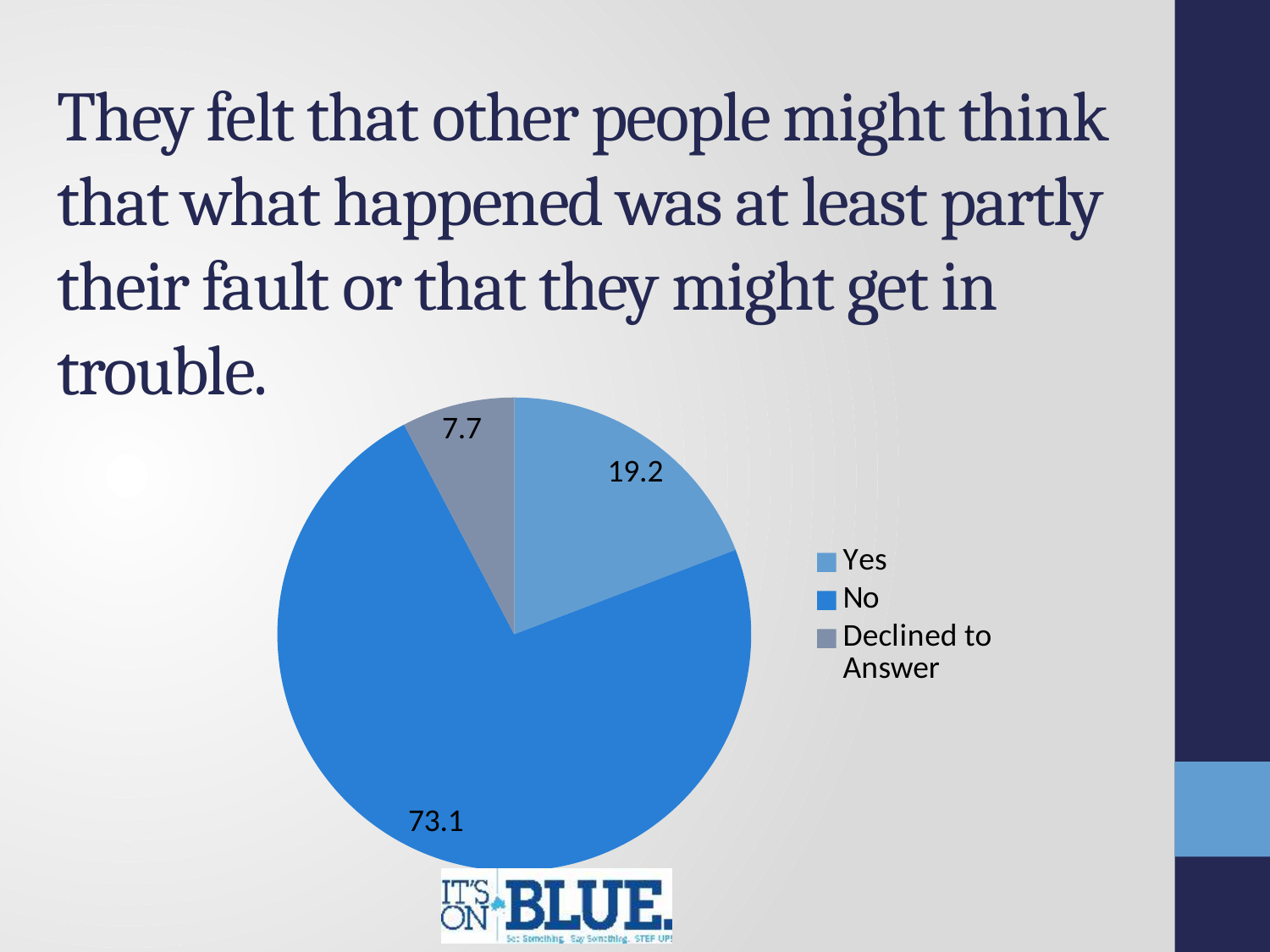
What is the value for the "Declined to Answer" slice? 7.7 What is the difference between the "Yes" value and the "Declined to Answer" value? 11.5 Which category has the smallest slice? Declined to Answer How many entries does the legend list? 3 What kind of chart is shown on the slide? pie chart How many slices does the pie chart have? 3 What is the value for the "No" slice? 73.1 Which is larger, the "Yes" slice or the "Declined to Answer" slice? Yes What is the value for the "Yes" slice? 19.2 Which category has the largest slice? No What is the difference between the "No" value and the "Yes" value? 53.9 What colour is the "Declined to Answer" slice? grey